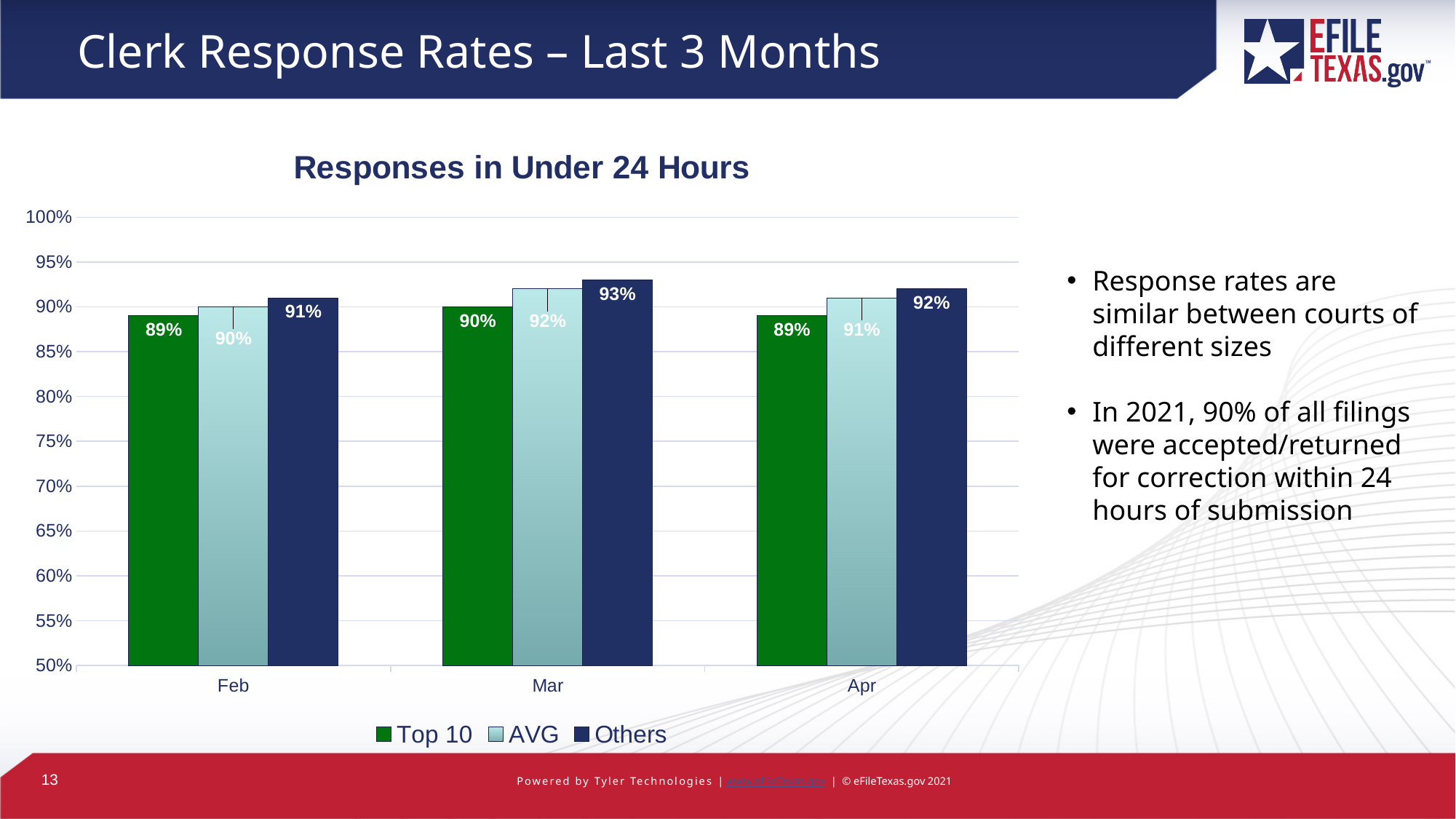
Which is larger in Apr, the Top 10 value or the Others value? Others How many series does the legend list? 3 What kind of chart is shown? Bar chart Which month has the highest Others value? Mar Which month has the lowest AVG value? Feb What is the Top 10 value for Feb? 89% What is the AVG value for Apr? 91% How many months are shown on the x axis? 3 What is the title of the chart? Responses in Under 24 Hours What is the Others value for Mar? 93% Which series is shown in green? Top 10 What is the difference between the Others and Top 10 values for Mar? 3%